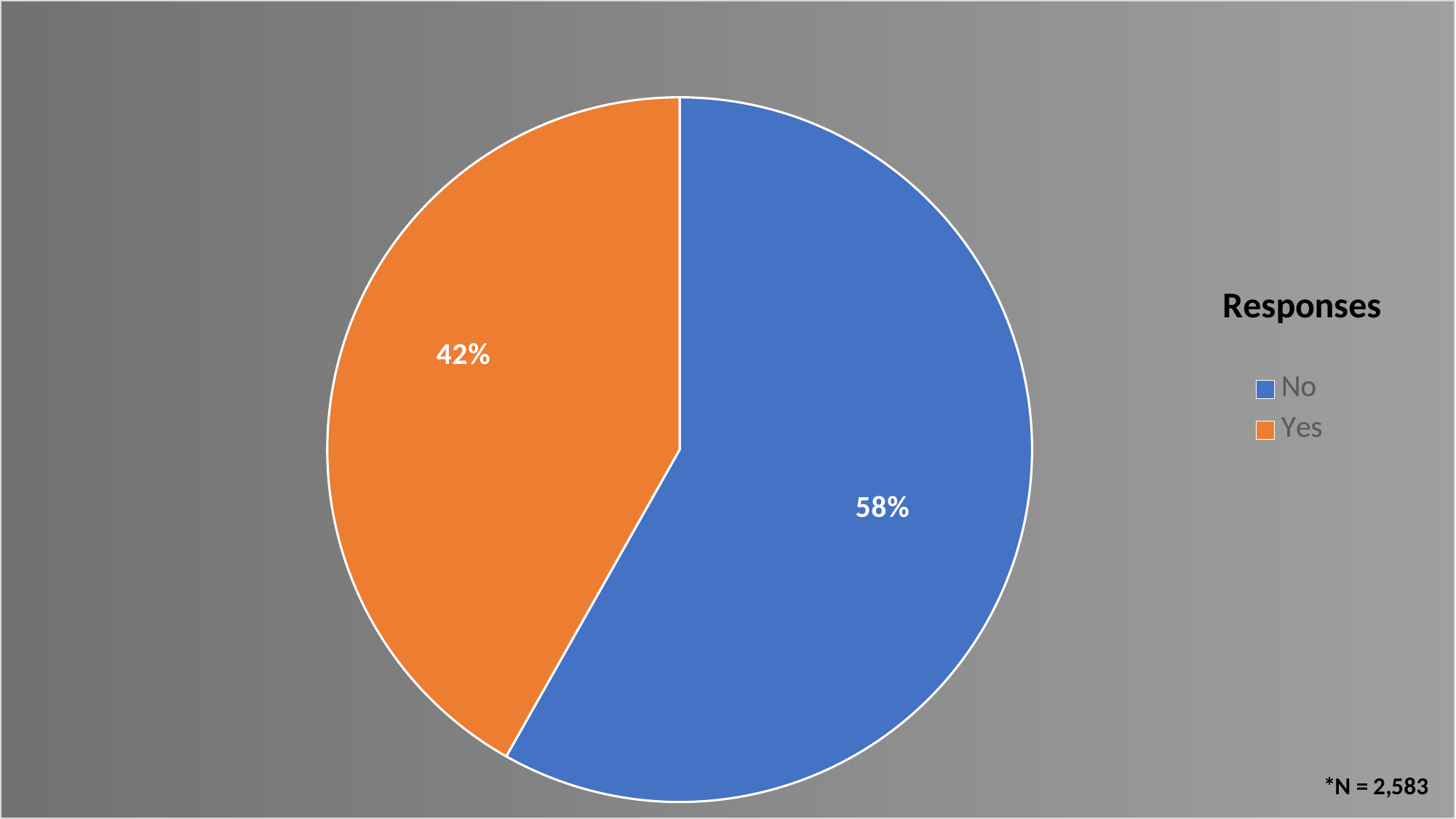
What kind of chart is shown on the slide? pie chart What colour is the "Yes" slice? orange Which response has the smallest share of the pie? Yes How many slices does the pie chart have? 2 What share of responses is "Yes"? 42% What is the title of the legend? Responses Which response has the largest share of the pie? No Which is larger, the "Yes" share or the "No" share? No What is the difference in percentage points between the "No" and "Yes" shares? 16 What share of responses is "No"? 58% What is the sample size (N) noted on the slide? 2,583 How many entries does the legend list? 2